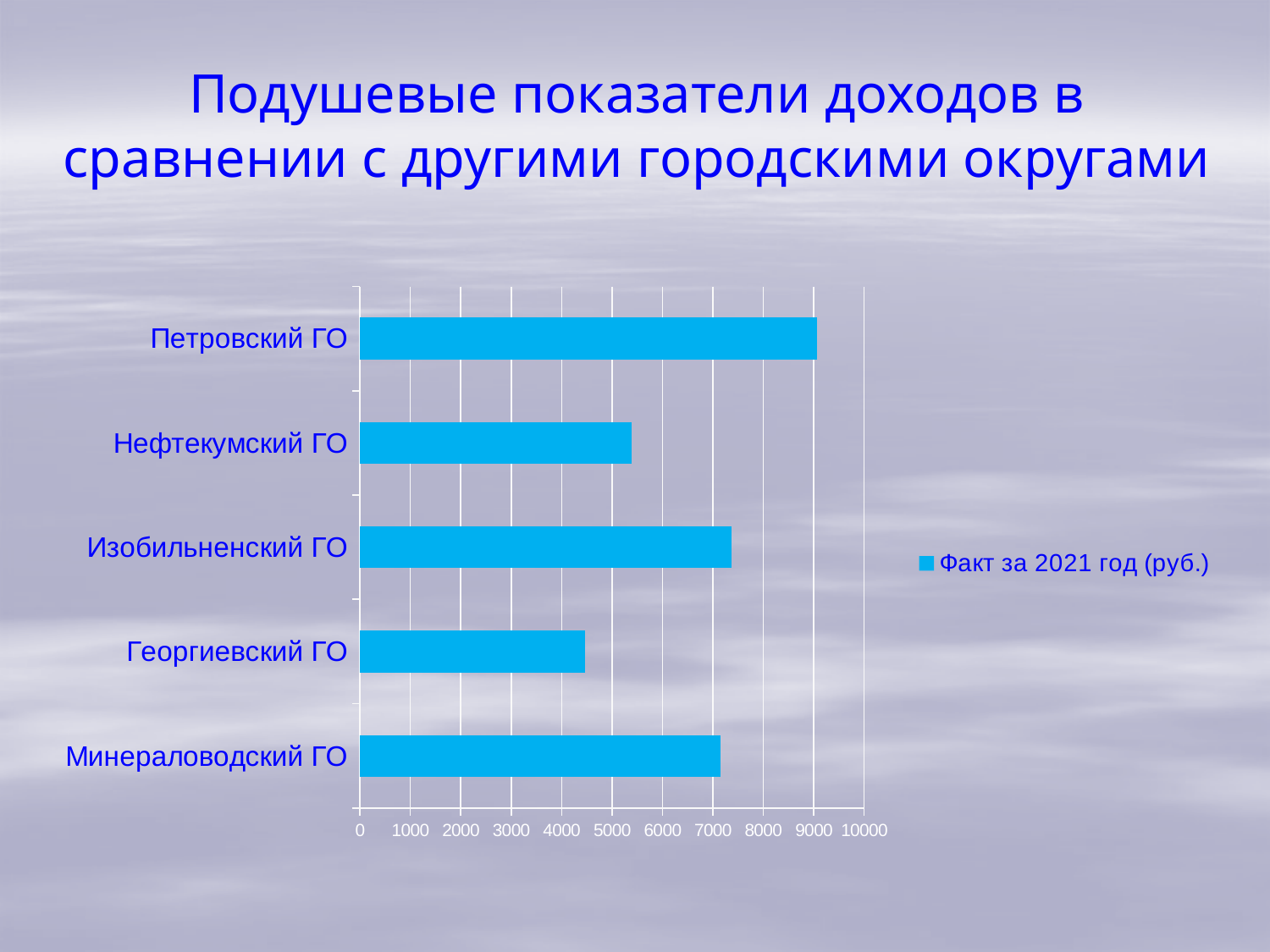
Which city district has the lowest value in the chart? Георгиевский ГО Is the value for Минераловодский ГО greater or less than 8000? less What kind of chart is shown on the slide? bar chart Is the value for Нефтекумский ГО greater or less than 6000? less How many series does the legend list? 1 How many city districts (categories) are shown in the chart? 5 Is the value for Георгиевский ГО greater or less than 5000? less Which has a larger value, Петровский ГО or Нефтекумский ГО? Петровский ГО What is the name of the series shown in the legend? Факт за 2021 год (руб.) Which city district has the highest value in the chart? Петровский ГО